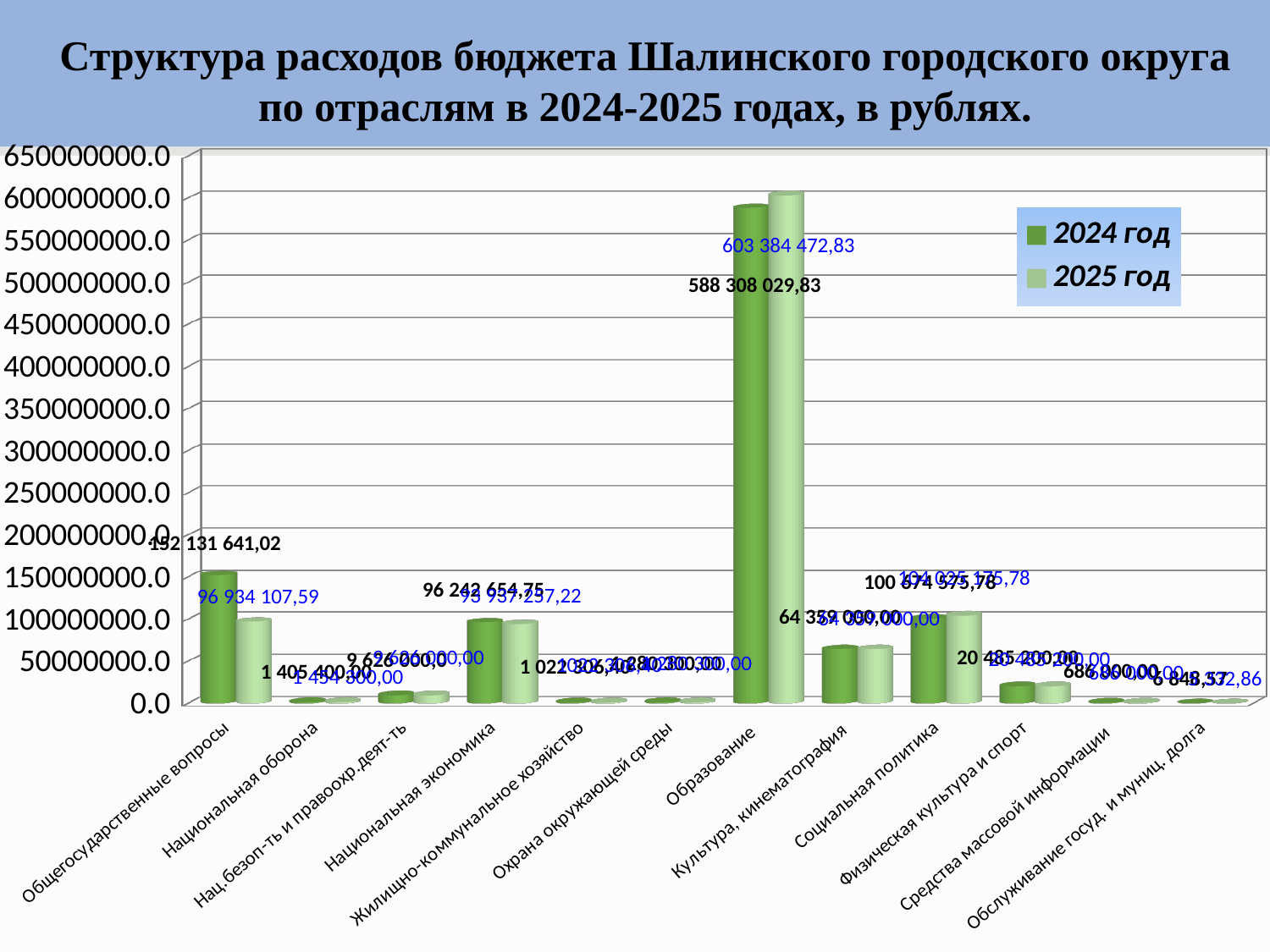
What is the 2024 год value for Общегосударственные вопросы? 152 131 641,02 How many series does the legend list? 2 Is the 2024 год value for Социальная политика greater or less than 50000000.0? greater What is the 2025 год value for Общегосударственные вопросы? 96 934 107,59 Which category has the highest expenditure in 2025 год? Образование For Образование, which year has the larger value, 2024 год or 2025 год? 2025 год For Общегосударственные вопросы, which year has the larger value, 2024 год or 2025 год? 2024 год How many categories are shown on the x axis? 12 What is the 2024 год value for Образование? 588 308 029,83 What is the 2024 год value for Национальная экономика? 96 242 654,75 What is the difference between the 2025 год and 2024 год values for Образование? 15 076 443,00 What is the 2025 год value for Образование? 603 384 472,83